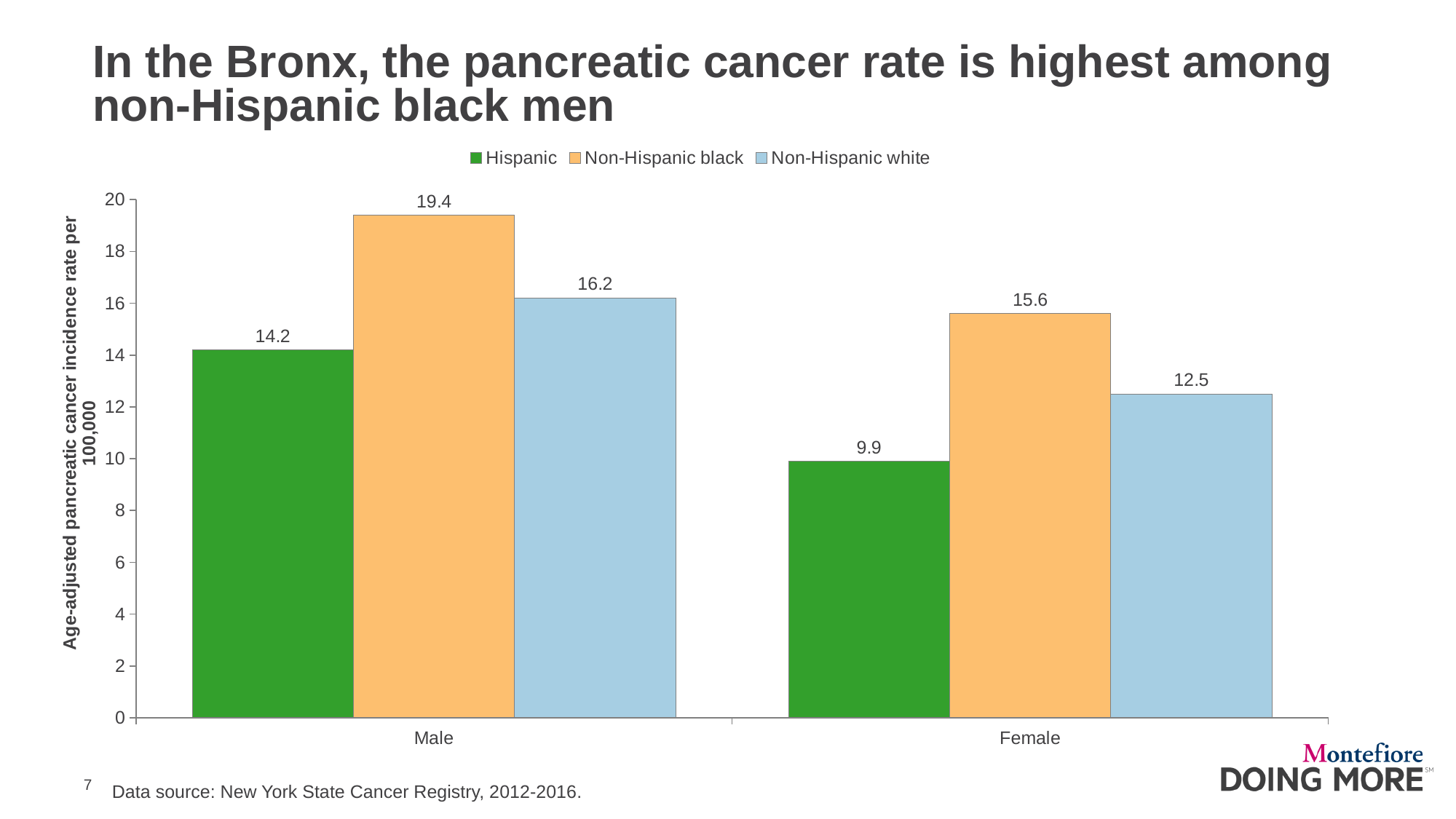
Which group has the highest pancreatic cancer incidence rate among males? Non-Hispanic black What is the pancreatic cancer incidence rate for Non-Hispanic white females? 12.5 What kind of chart is shown on the slide? Bar chart What is the pancreatic cancer incidence rate for Hispanic females? 9.9 Which is larger, the Hispanic male rate or the Non-Hispanic white female rate? Hispanic male rate How many series does the legend list? 3 What is the pancreatic cancer incidence rate for Non-Hispanic black males? 19.4 How many categories are shown on the x axis? 2 Which colour represents the Non-Hispanic black series? Orange What is the difference between the Non-Hispanic white male rate and the Hispanic male rate? 2.0 What is the difference between the Non-Hispanic black male rate and the Non-Hispanic black female rate? 3.8 Which group has the lowest pancreatic cancer incidence rate among females? Hispanic